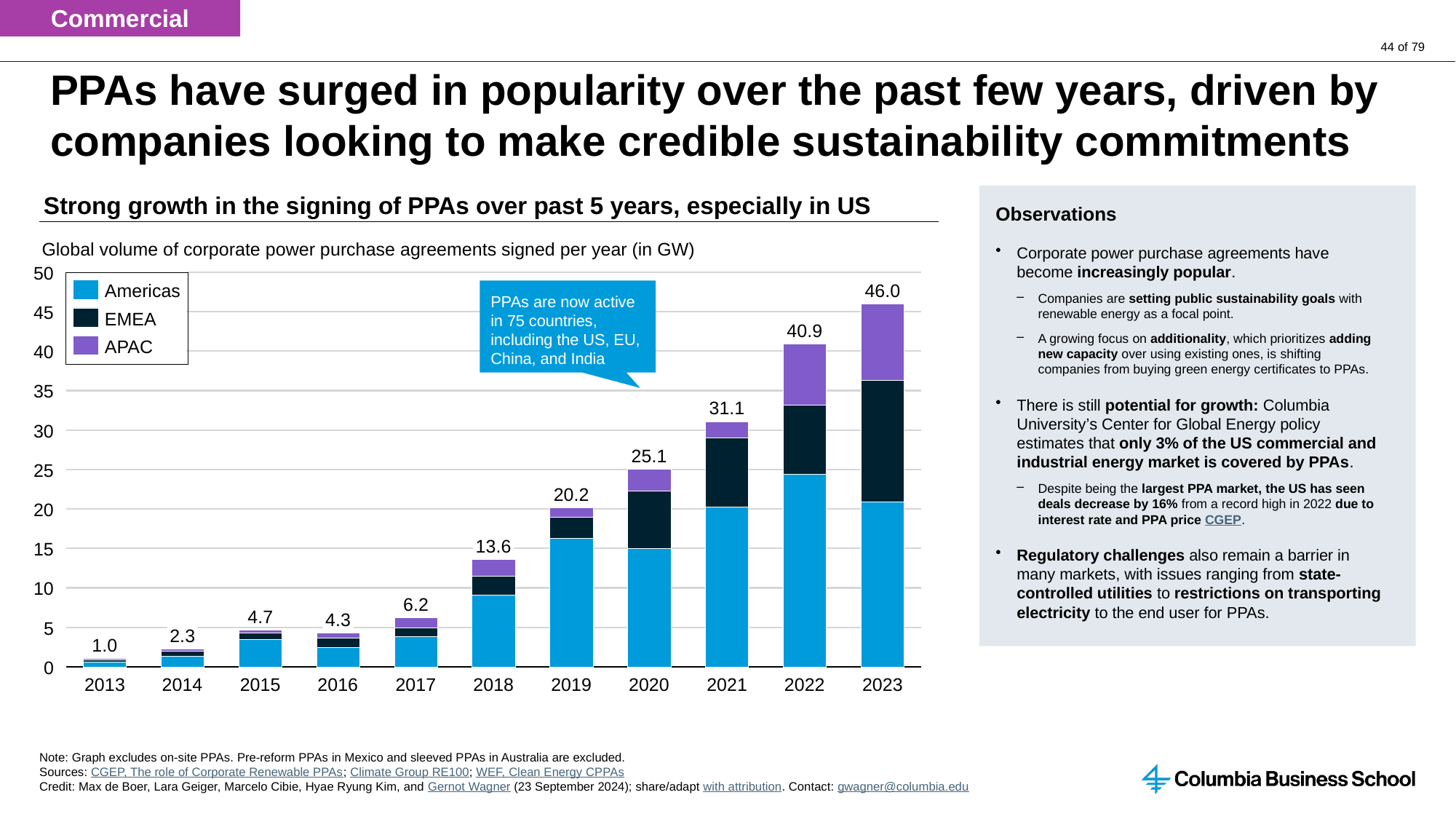
What kind of chart is used to show the global volume of corporate PPAs? Stacked bar chart Which year had a larger total volume, 2015 or 2016? 2015 Do the total volumes rise or fall from 2016 to 2023? Rise Which year has the lowest total volume of PPAs signed? 2013 Which year has the highest total volume of PPAs signed? 2023 Which region is shown in purple in the chart legend? APAC Is the Americas value for 2022 greater or less than 20? greater What value is labeled on the bar for 2018? 13.6 How many series does the chart legend list? 3 By how much did the total volume increase from 2022 to 2023? 5.1 What is the total global volume of corporate PPAs signed in 2023 according to the chart? 46.0 How many years are shown on the x axis of the chart? 11